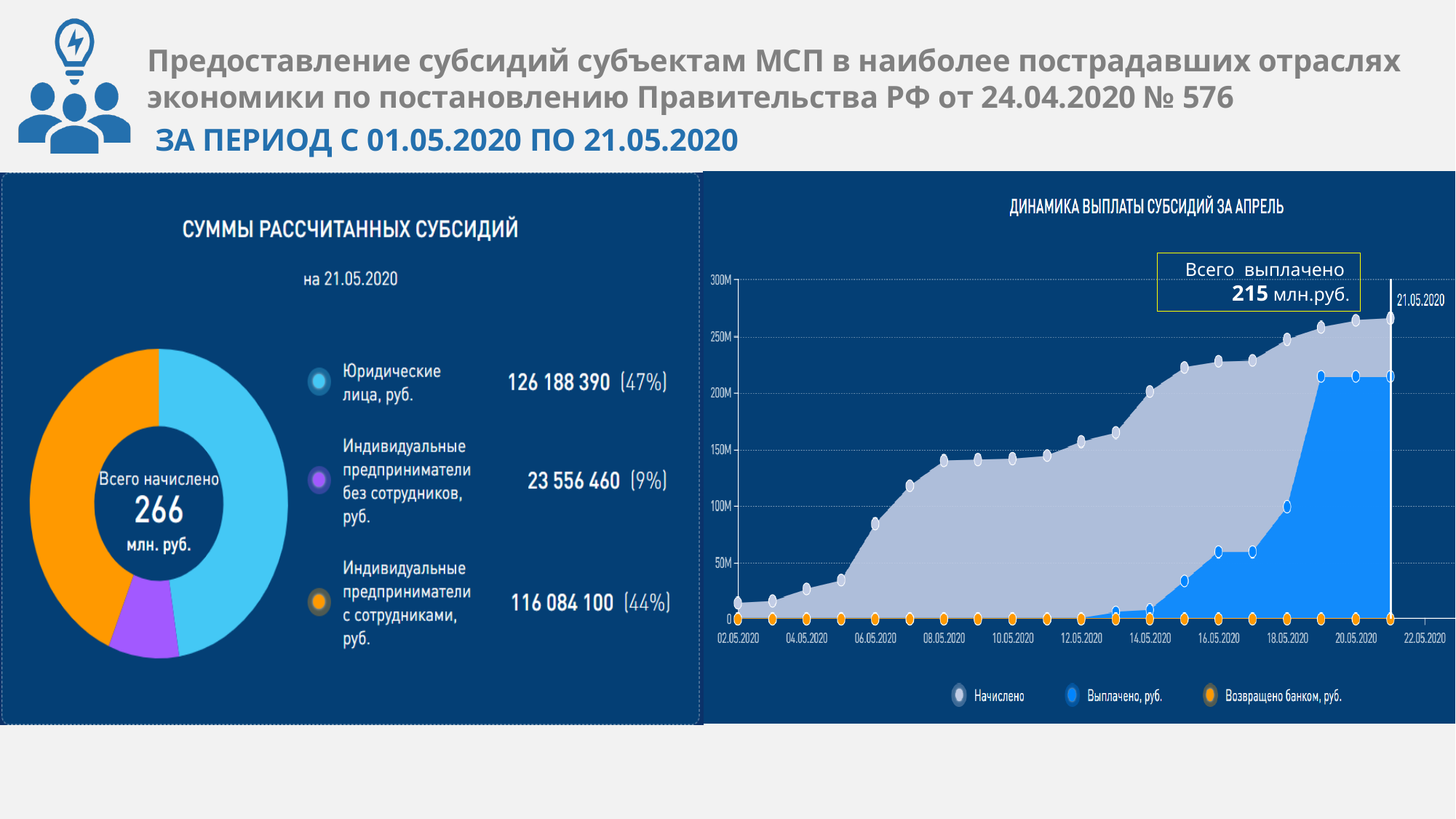
In the donut chart 'СУММЫ РАССЧИТАННЫХ СУБСИДИЙ', what is the difference between the value for Юридические лица and the value for Индивидуальные предприниматели с сотрудниками? 10 104 290 In the donut chart 'СУММЫ РАССЧИТАННЫХ СУБСИДИЙ', which category has the smallest value? Индивидуальные предприниматели без сотрудников How many categories does the donut chart 'СУММЫ РАССЧИТАННЫХ СУБСИДИЙ' show? 3 In the donut chart 'СУММЫ РАССЧИТАННЫХ СУБСИДИЙ', what total amount is shown in the centre (Всего начислено)? 266 млн. руб. In the chart 'ДИНАМИКА ВЫПЛАТЫ СУБСИДИЙ ЗА АПРЕЛЬ', what total paid amount (Всего выплачено) is shown in the callout? 215 млн.руб. In the chart 'ДИНАМИКА ВЫПЛАТЫ СУБСИДИЙ ЗА АПРЕЛЬ', is the value of Начислено on 10.05.2020 greater or less than 100M? greater In the chart 'ДИНАМИКА ВЫПЛАТЫ СУБСИДИЙ ЗА АПРЕЛЬ', does the Начислено series rise or fall from 02.05.2020 to 21.05.2020? rise In the donut chart 'СУММЫ РАССЧИТАННЫХ СУБСИДИЙ', what is the value for Индивидуальные предприниматели без сотрудников, руб.? 23 556 460 In the donut chart 'СУММЫ РАССЧИТАННЫХ СУБСИДИЙ', which category has the largest value? Юридические лица In the donut chart 'СУММЫ РАССЧИТАННЫХ СУБСИДИЙ', what is the value for Юридические лица, руб.? 126 188 390 In the donut chart 'СУММЫ РАССЧИТАННЫХ СУБСИДИЙ', what share of the total do Юридические лица account for? 47% How many series does the legend of the chart 'ДИНАМИКА ВЫПЛАТЫ СУБСИДИЙ ЗА АПРЕЛЬ' list? 3